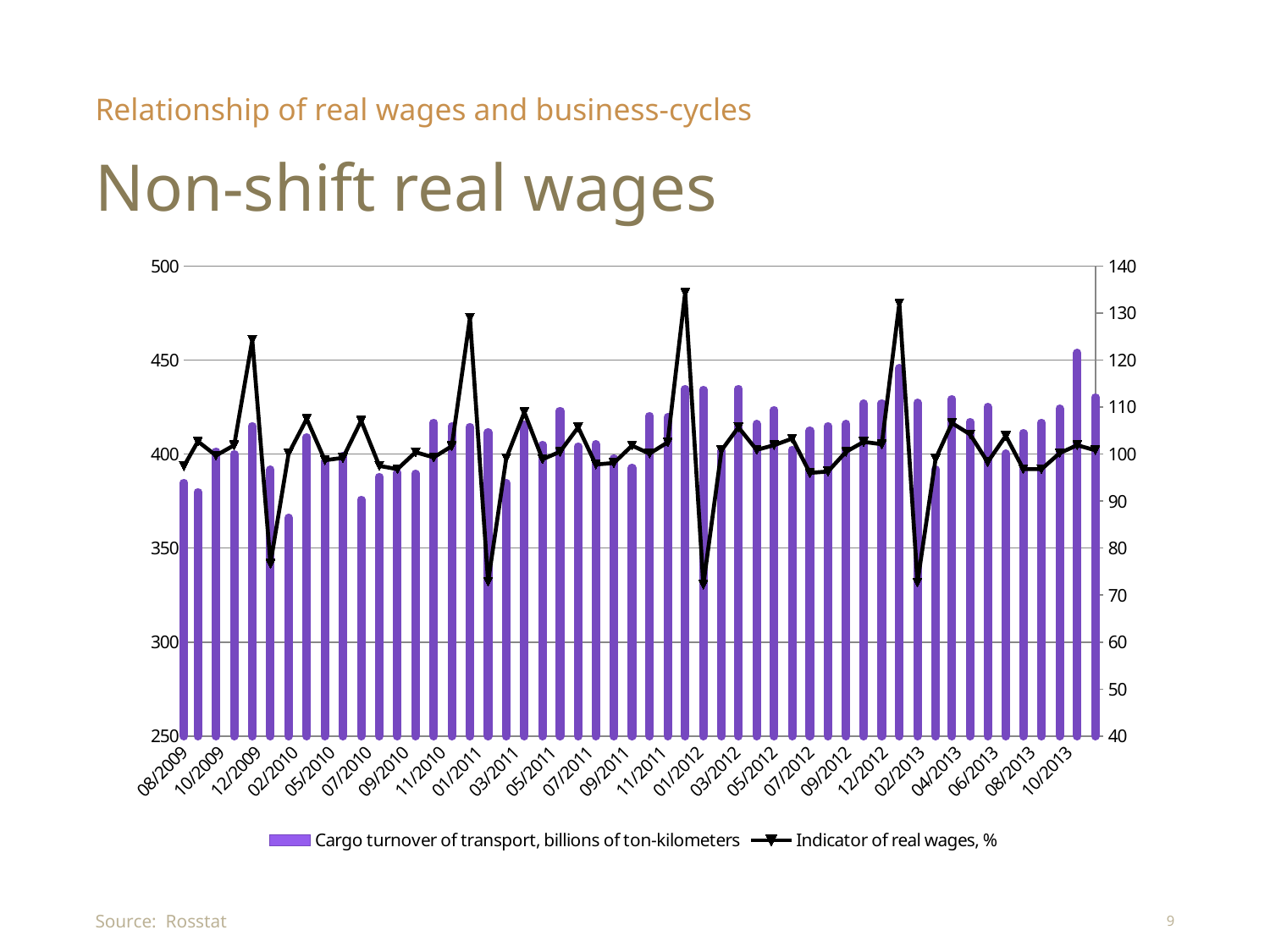
Is the cargo turnover of transport for 02/2010 greater or less than 400? less How many series does the legend list? 2 Is the cargo turnover of transport for 10/2013 greater or less than 400? greater Which is larger, the indicator of real wages for 01/2012 or for 02/2013? 01/2012 Is the cargo turnover of transport for 08/2009 greater or less than 400? less What kind of chart is shown on the slide? A combined bar and line chart Which series is plotted as bars? Cargo turnover of transport, billions of ton-kilometers Which series is plotted as the black line with triangle markers? Indicator of real wages, %